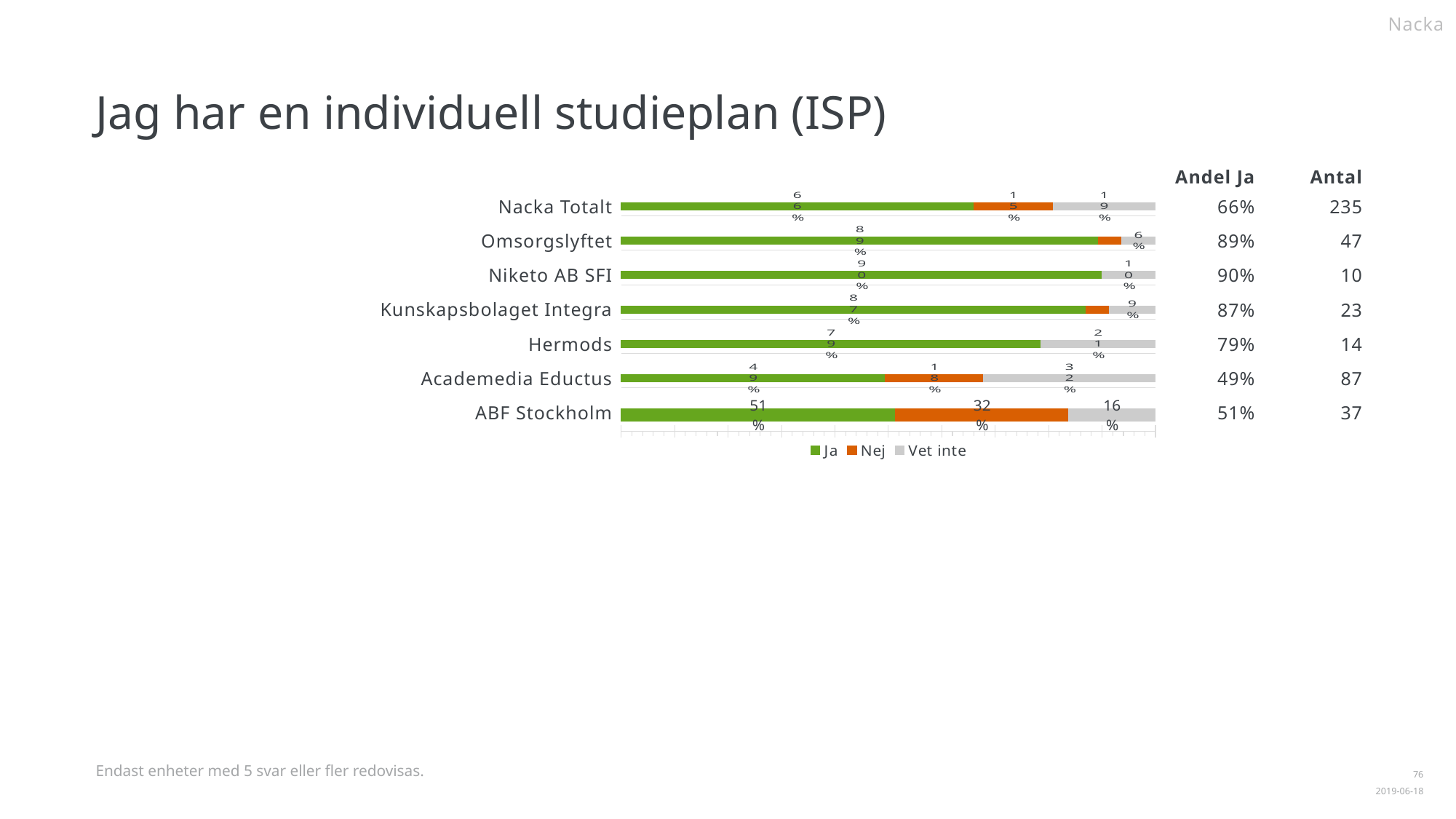
What is the Nej value for ABF Stockholm? 32% Which is larger, the Nej value for ABF Stockholm or the Nej value for Nacka Totalt? ABF Stockholm What kind of chart is shown on the slide? Stacked bar chart How many series does the legend list? 3 What is the Vet inte value for Academedia Eductus? 32% Which category has the highest Ja value? Niketo AB SFI What are the legend entries of the chart? Ja, Nej, Vet inte What is the Vet inte value for Nacka Totalt? 19% What is the difference between the Ja value for Hermods and the Ja value for Nacka Totalt? 13 percentage points What is the Ja value for Niketo AB SFI? 90% How many categories are shown in the chart? 7 Which category has the lowest Ja value? Academedia Eductus